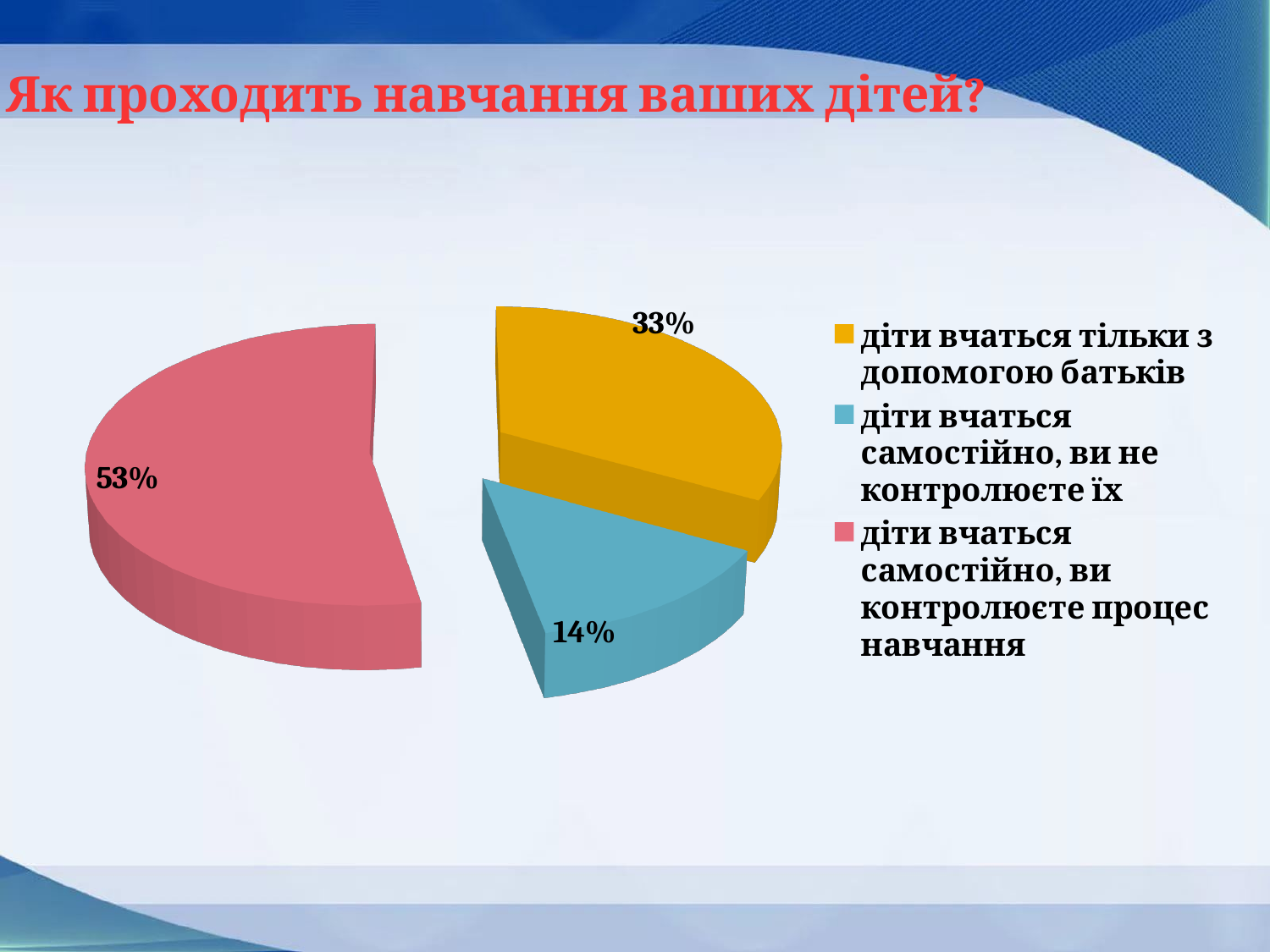
What share of the pie is labelled 'діти вчаться самостійно, ви контролюєте процес навчання'? 53% How many slices does the pie chart have? 3 Which is larger: the slice for 'діти вчаться тільки з допомогою батьків' or the slice for 'діти вчаться самостійно, ви не контролюєте їх'? діти вчаться тільки з допомогою батьків How many entries does the legend list? 3 What kind of chart is shown on the slide? pie chart What share of the pie is labelled 'діти вчаться самостійно, ви не контролюєте їх'? 14% What colour is the slice for 'діти вчаться самостійно, ви не контролюєте їх'? blue What share of the pie is labelled 'діти вчаться тільки з допомогою батьків'? 33% What is the difference in percentage points between the largest slice (53%) and the slice for 'діти вчаться тільки з допомогою батьків' (33%)? 20 Which category has the largest slice of the pie? діти вчаться самостійно, ви контролюєте процес навчання What is the title of the slide above the chart? Як проходить навчання ваших дітей? Which category has the smallest slice of the pie? діти вчаться самостійно, ви не контролюєте їх